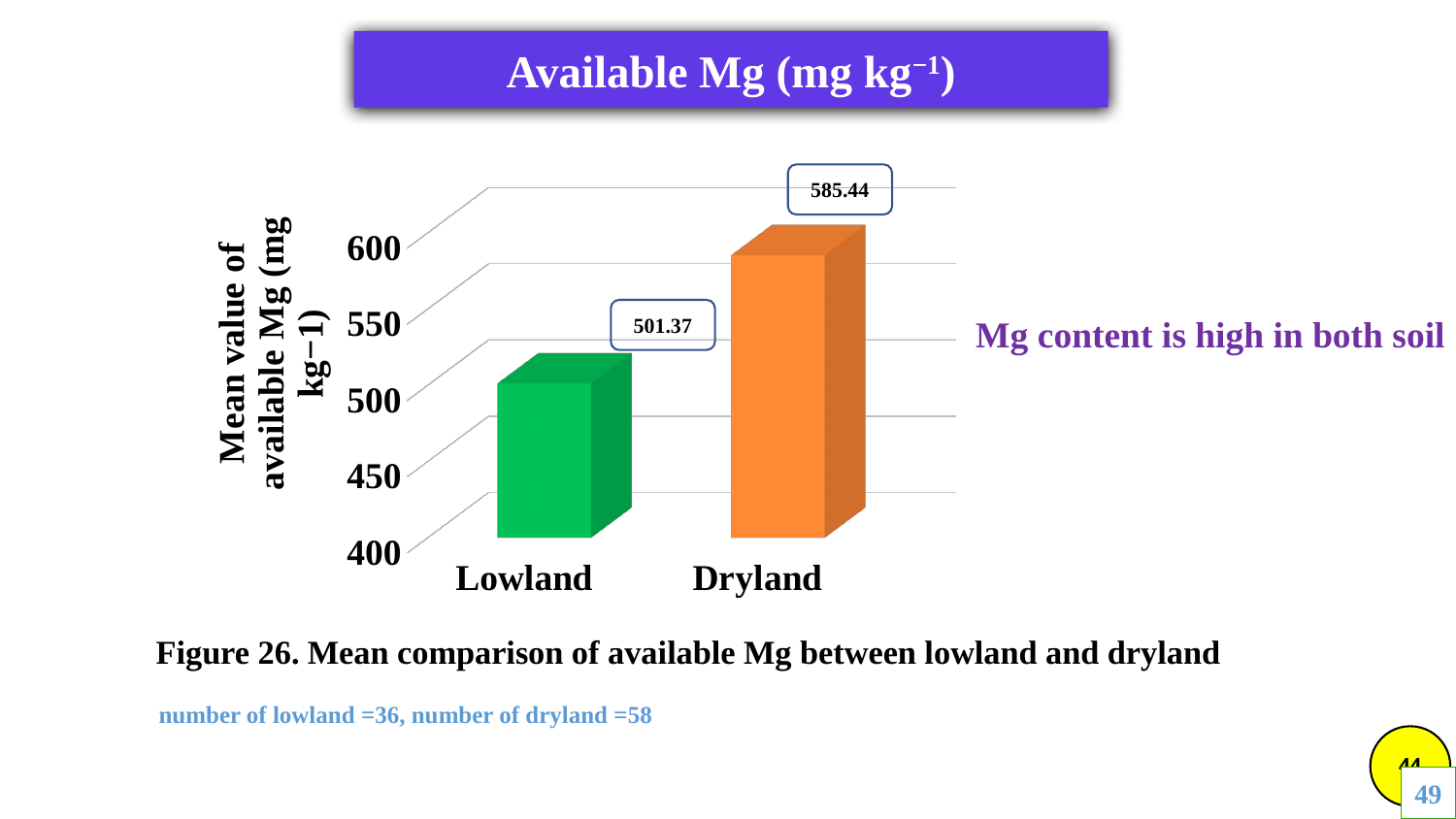
What colour is the bar for Dryland? orange Is the value for Lowland greater or less than 550? less What kind of chart is shown on the slide? bar chart Which category has the lower mean value of available Mg? Lowland How many categories are shown on the x axis of the chart? 2 What is the difference between the Dryland and Lowland mean values of available Mg? 84.06 Which category has the higher mean value of available Mg? Dryland Is the Lowland value larger or smaller than the Dryland value? smaller Is the value for Dryland greater or less than 550? greater What is the mean value of available Mg for Lowland? 501.37 What is the mean value of available Mg for Dryland? 585.44 What is the title shown above the chart? Available Mg (mg kg⁻¹)